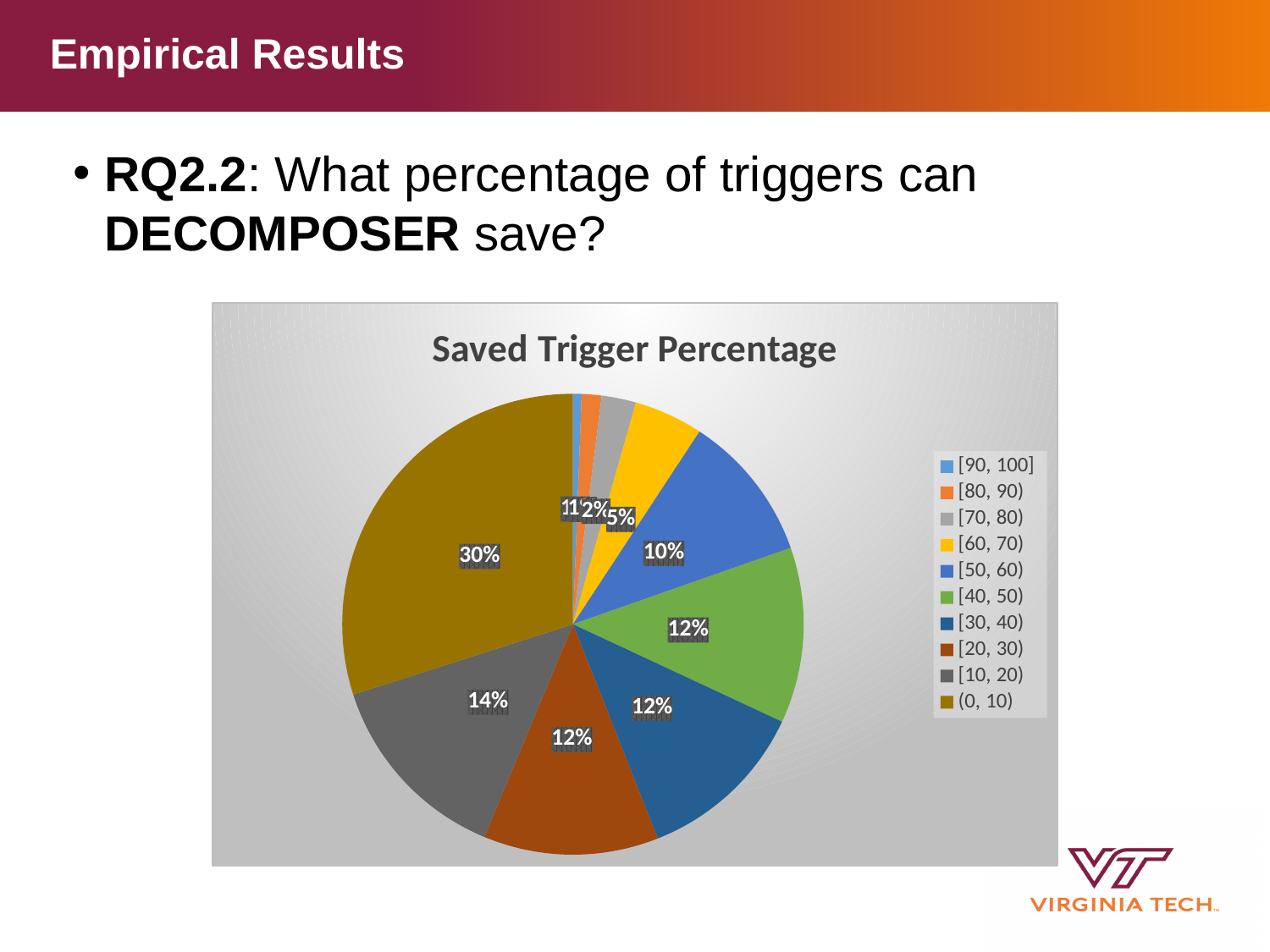
What share of the pie does the [60, 70) category have? 5% What share of the pie does the [50, 60) category have? 10% What is the title of the chart? Saved Trigger Percentage What share of the pie does the [10, 20) category have? 14% What is the difference in percentage points between the (0, 10) slice and the [10, 20) slice? 16 What kind of chart is shown on the slide? pie chart How many categories does the legend of the pie chart list? 10 Which category has the largest slice of the pie? (0, 10) Which slice is larger, [50, 60) or [60, 70)? [50, 60) Which colour is used for the (0, 10) category in the legend? dark yellow (olive gold)